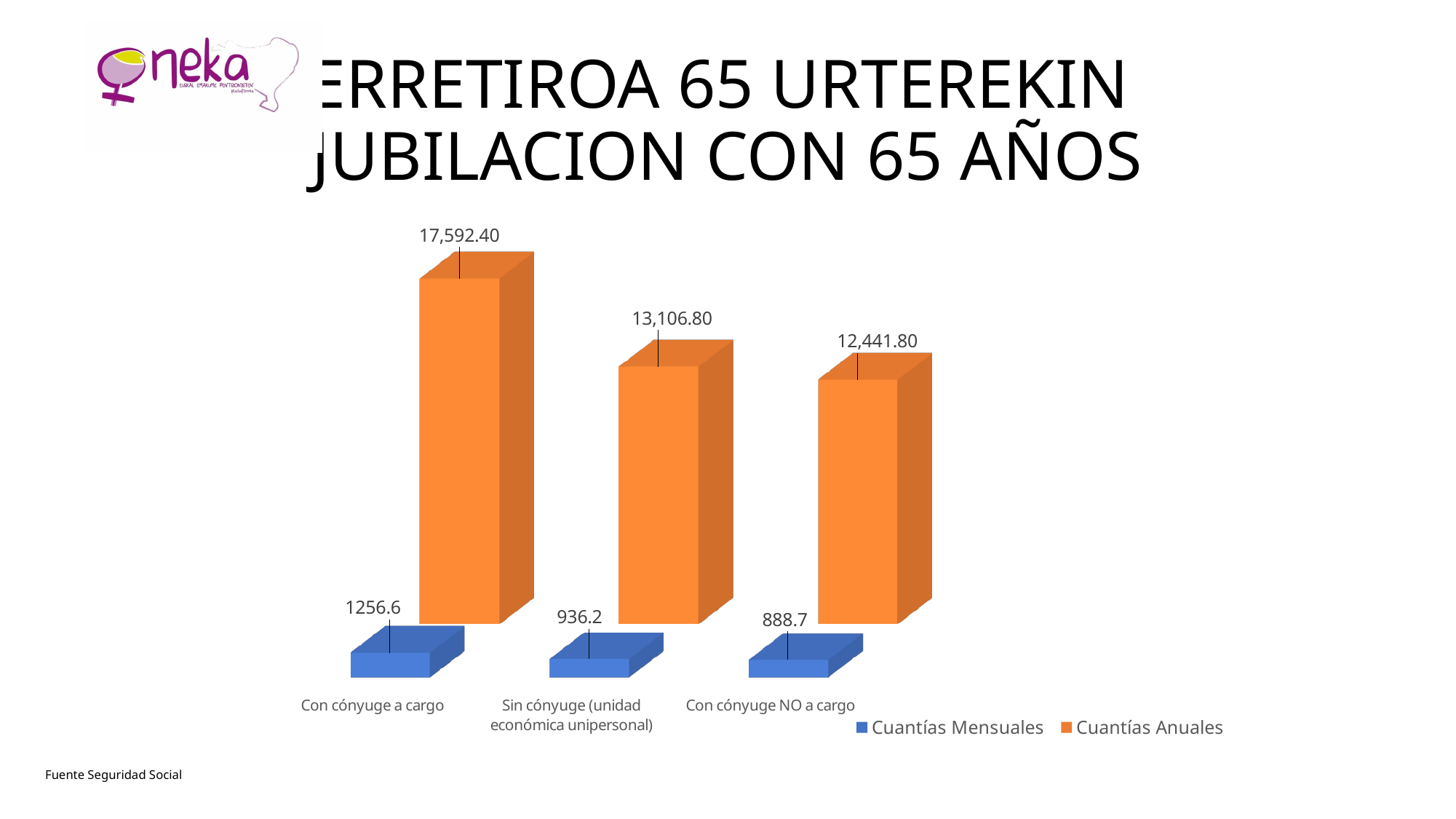
Which category has the lowest Cuantías Mensuales value? Con cónyuge NO a cargo Which is larger: the Cuantías Anuales value for Sin cónyuge (unidad económica unipersonal) or for Con cónyuge NO a cargo? Sin cónyuge (unidad económica unipersonal) How many series does the chart legend list? 2 Which category has the highest Cuantías Anuales value? Con cónyuge a cargo What is the difference between the Cuantías Mensuales values for Con cónyuge a cargo and Con cónyuge NO a cargo? 367.9 What is the value of Cuantías Mensuales for Sin cónyuge (unidad económica unipersonal)? 936.2 What is the value of Cuantías Anuales for Con cónyuge a cargo? 17,592.40 How many categories are shown on the x axis of the chart? 3 What kind of chart is shown on the slide? Bar chart What is the difference between the Cuantías Anuales values for Con cónyuge a cargo and Sin cónyuge (unidad económica unipersonal)? 4,485.60 What is the value of Cuantías Mensuales for Con cónyuge NO a cargo? 888.7 What is the value of Cuantías Anuales for Con cónyuge NO a cargo? 12,441.80